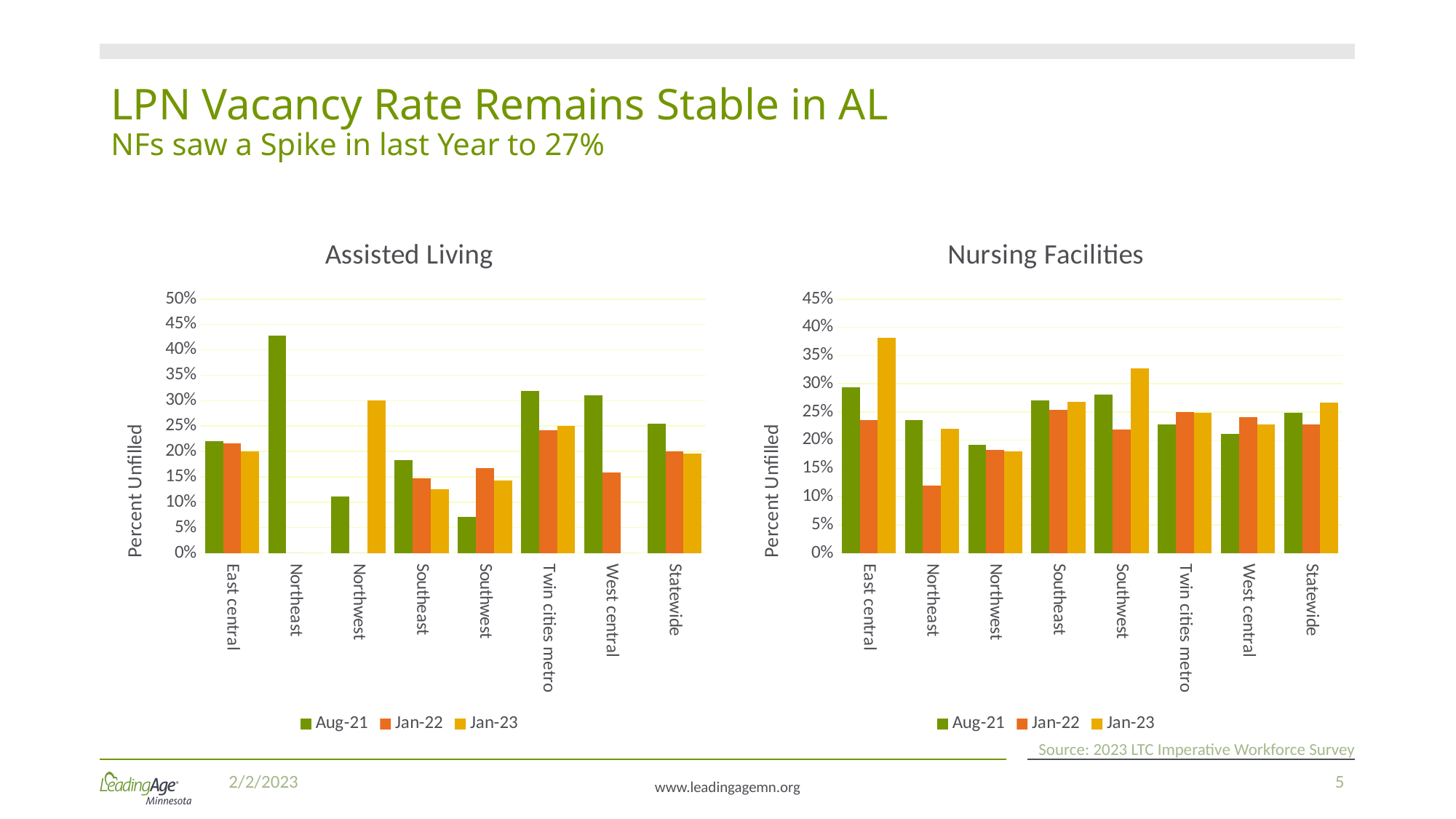
What kind of chart is the Assisted Living chart? Bar chart How many regional categories are shown on the x axis of the Assisted Living chart? 8 In the Assisted Living chart, which category has the lowest Aug-21 value? Southwest What is the y-axis title of the Assisted Living chart? Percent Unfilled In the Nursing Facilities chart, which is larger for Southwest: the Jan-22 value or the Jan-23 value? Jan-23 In the Nursing Facilities chart, which category has the lowest Jan-22 value? Northeast In the Assisted Living chart, which category has the highest Aug-21 value? Northeast In the Assisted Living chart, is the Aug-21 value for Northeast greater or less than 40%? greater In the Nursing Facilities chart, is the Jan-22 value for Northeast greater or less than 15%? less In the Nursing Facilities chart, which category has the highest Jan-23 value? East central In the Nursing Facilities chart, is the Jan-23 value for East central greater or less than 35%? greater How many series does the legend of the Nursing Facilities chart list? 3